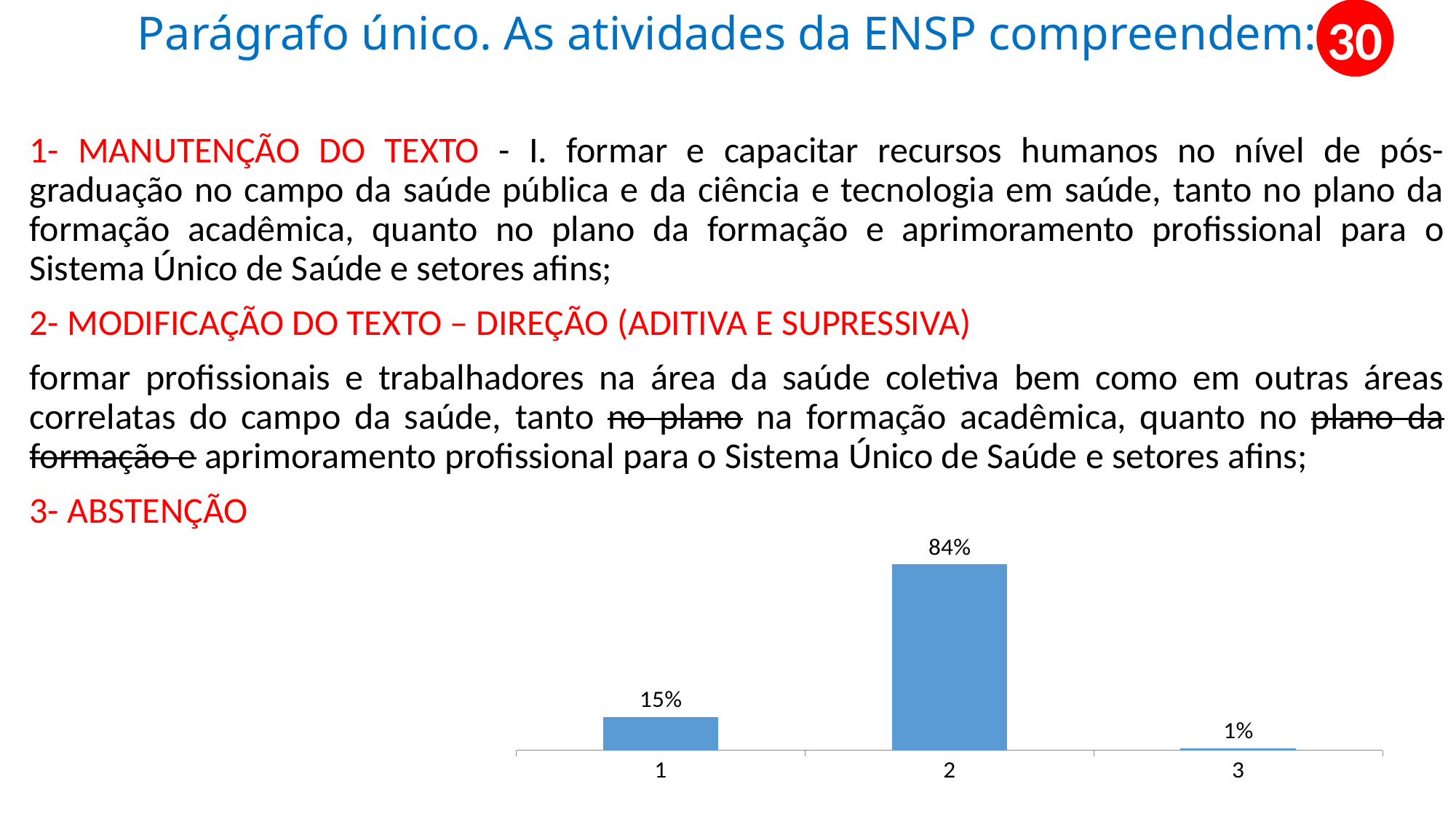
What is the value shown for category 1 in the chart? 15% What is the difference between the values for category 1 and category 3? 14% How many categories are shown in the chart? 3 What is the value shown for category 3 in the chart? 1% Which is larger, the value for category 1 or the value for category 3? 1 What colour are the bars in the chart? blue Which category has the highest value in the chart? 2 What is the value shown for category 2 in the chart? 84% What is the total of the three values shown in the chart? 100% What kind of chart is shown on the slide? bar chart Which category has the lowest value in the chart? 3 What is the difference between the values for category 2 and category 1? 69%